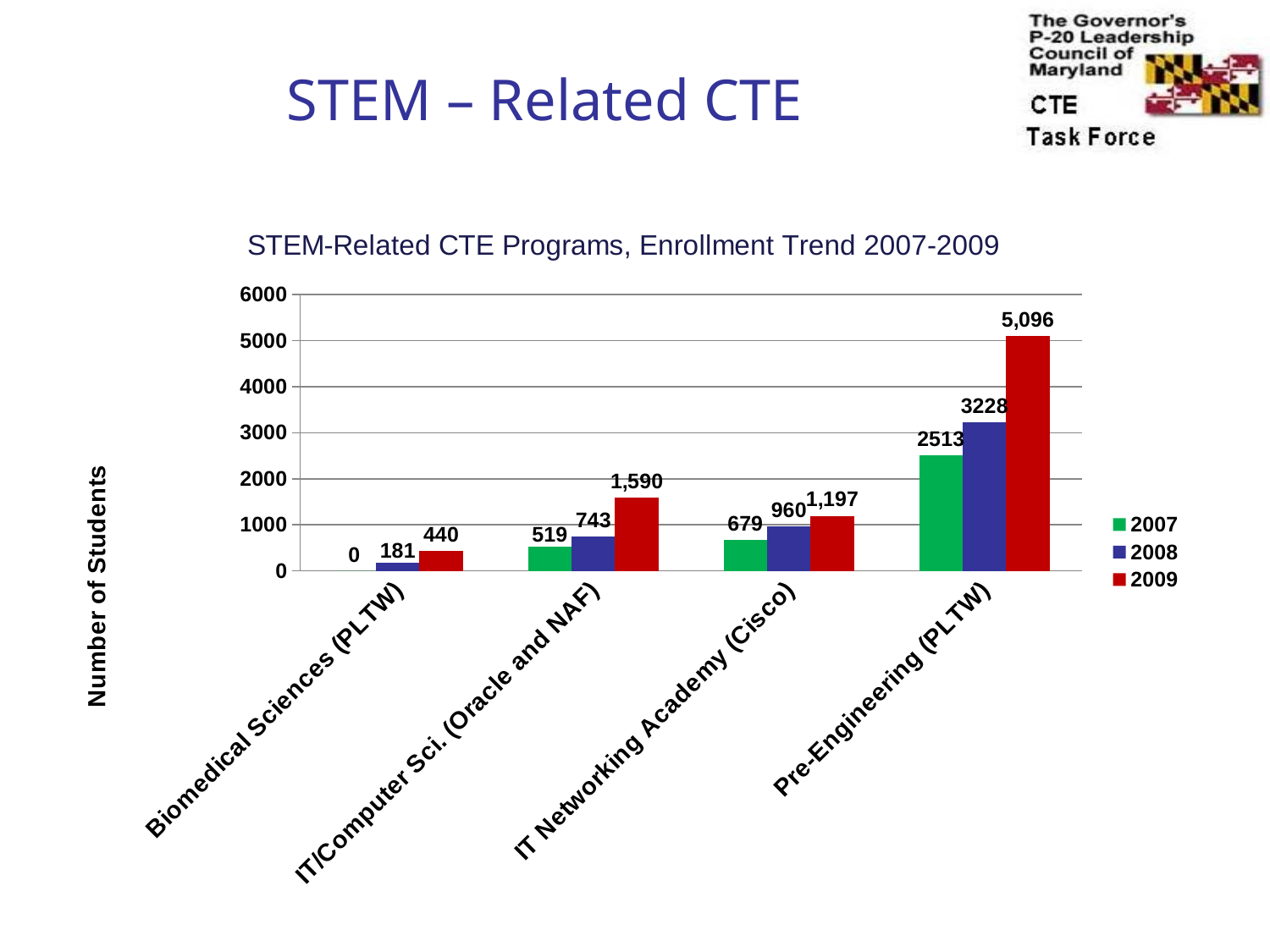
Which program had the lowest enrollment in 2008? Biomedical Sciences (PLTW) What was the 2009 enrollment for Pre-Engineering (PLTW)? 5,096 What was the 2007 enrollment for Biomedical Sciences (PLTW)? 0 How many programs are shown on the x axis? 4 Which is larger: the 2009 enrollment for IT/Computer Sci. (Oracle and NAF) or for IT Networking Academy (Cisco)? IT/Computer Sci. (Oracle and NAF) What is the difference between the 2009 and 2007 enrollment for Pre-Engineering (PLTW)? 2,583 Which program had the highest enrollment in 2009? Pre-Engineering (PLTW) Did enrollment for IT Networking Academy (Cisco) rise or fall from 2007 to 2009? Rise What was the 2008 enrollment for IT/Computer Sci. (Oracle and NAF)? 743 What is the title of the chart? STEM-Related CTE Programs, Enrollment Trend 2007-2009 What kind of chart is shown on the slide? Bar chart How many series does the legend list? 3